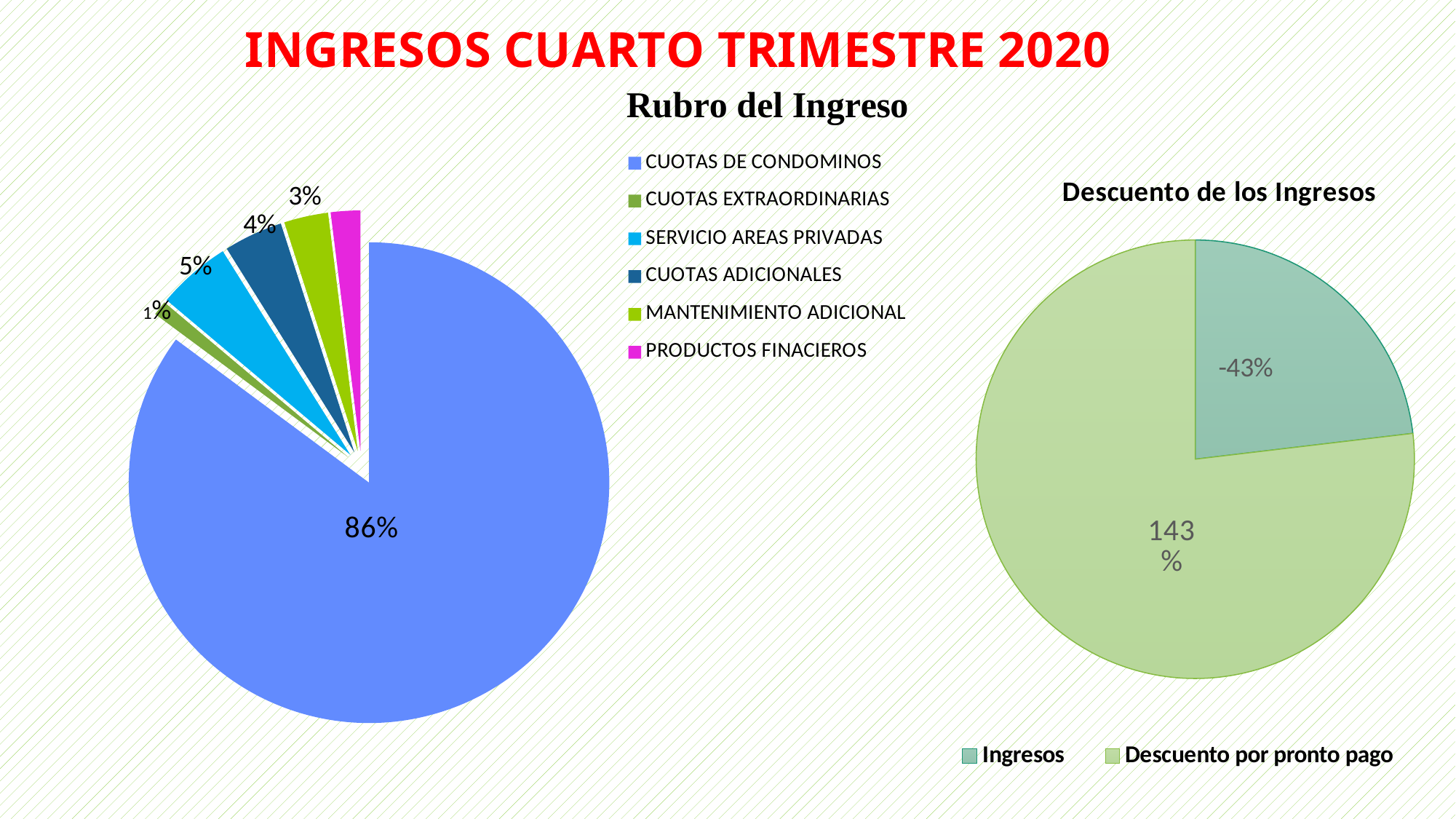
In the 'Rubro del Ingreso' chart, what percentage is shown for CUOTAS EXTRAORDINARIAS? 1% In the 'Rubro del Ingreso' chart, which is larger, SERVICIO AREAS PRIVADAS or CUOTAS ADICIONALES? SERVICIO AREAS PRIVADAS In the 'Rubro del Ingreso' chart, what percentage is shown for SERVICIO AREAS PRIVADAS? 5% What type of chart is 'Descuento de los Ingresos'? Pie chart In the 'Descuento de los Ingresos' chart, how many entries does the legend list? 2 In the 'Rubro del Ingreso' chart, how many categories does the legend list? 6 In the 'Descuento de los Ingresos' chart, what value is shown for Descuento por pronto pago? 143% In the 'Rubro del Ingreso' chart, what is the difference in percentage points between CUOTAS DE CONDOMINOS and SERVICIO AREAS PRIVADAS? 81 In the 'Rubro del Ingreso' chart, what percentage is shown for CUOTAS DE CONDOMINOS? 86% In the 'Rubro del Ingreso' chart, which category has the largest slice? CUOTAS DE CONDOMINOS In the 'Descuento de los Ingresos' chart, what value is shown for Ingresos? -43% In the 'Rubro del Ingreso' chart, what percentage is shown for CUOTAS ADICIONALES? 4%